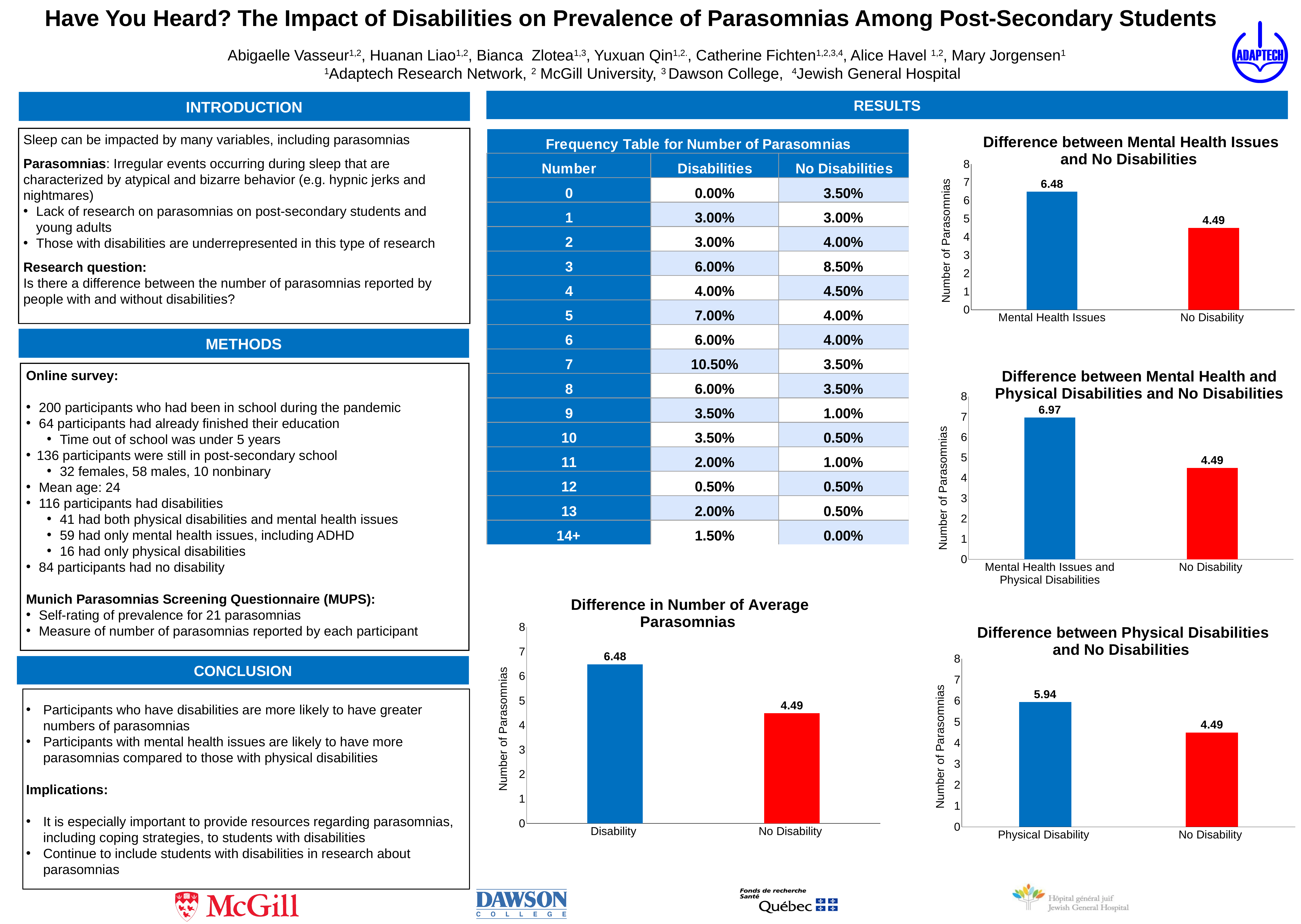
In the chart titled "Difference between Mental Health Issues and No Disabilities", is the value for Mental Health Issues greater or less than 6? greater In the chart titled "Difference between Mental Health and Physical Disabilities and No Disabilities", what is the value for Mental Health Issues and Physical Disabilities? 6.97 How many categories are shown in the chart titled "Difference between Physical Disabilities and No Disabilities"? 2 In the chart titled "Difference in Number of Average Parasomnias", what is the value for Disability? 6.48 In the chart titled "Difference in Number of Average Parasomnias", which category has the higher value? Disability What kind of chart is the one titled "Difference in Number of Average Parasomnias"? bar chart In the chart titled "Difference between Physical Disabilities and No Disabilities", which category has the lowest value? No Disability In the chart titled "Difference between Physical Disabilities and No Disabilities", what is the difference between the Physical Disability and No Disability values? 1.45 In the chart titled "Difference between Mental Health and Physical Disabilities and No Disabilities", what is the difference between the two bars? 2.48 In the chart titled "Difference between Physical Disabilities and No Disabilities", what is the value for Physical Disability? 5.94 In the chart titled "Difference between Mental Health Issues and No Disabilities", what is the value for Mental Health Issues? 6.48 In the chart titled "Difference in Number of Average Parasomnias", what is the value for No Disability? 4.49